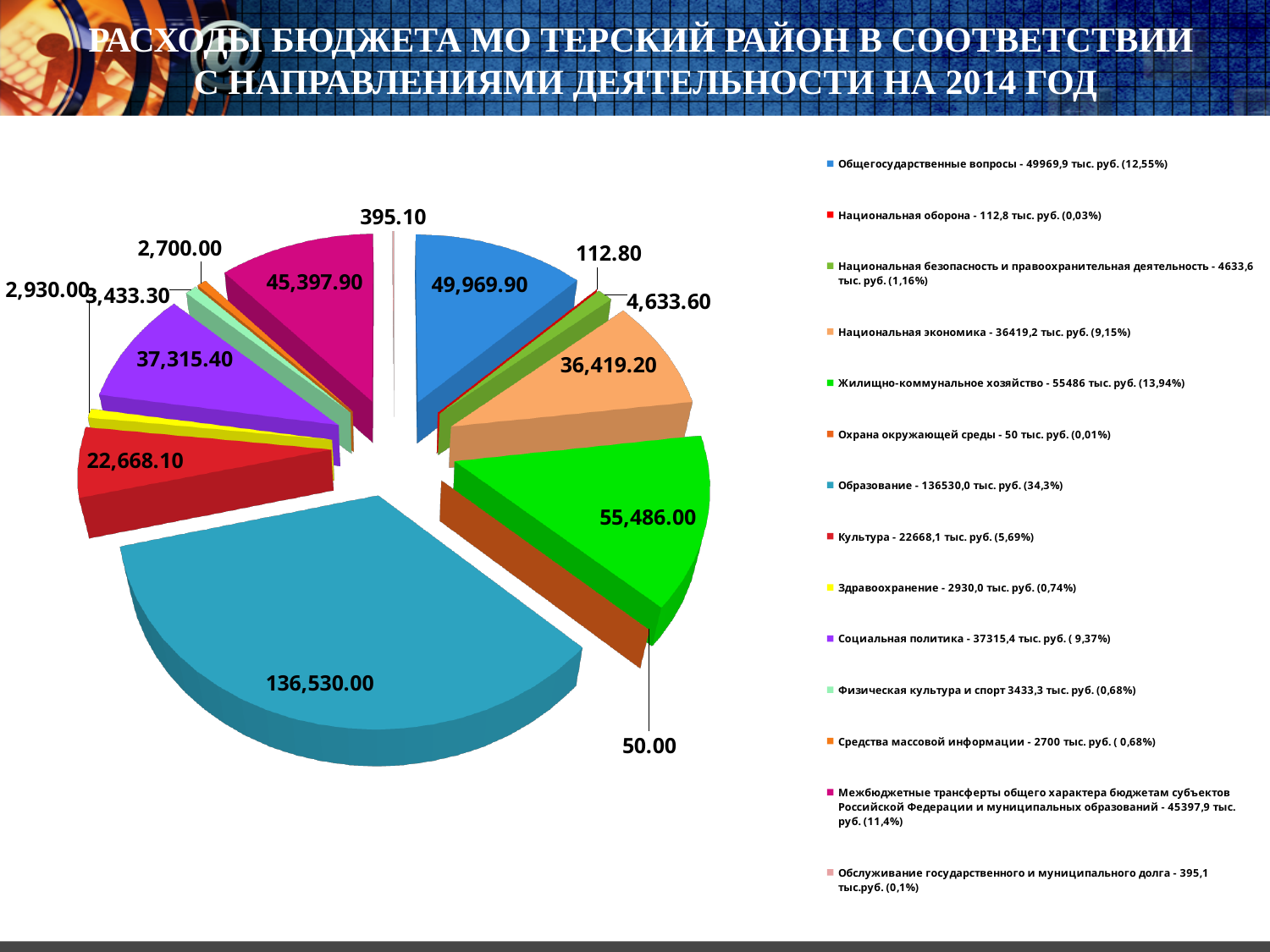
What is the value shown for Жилищно-коммунальное хозяйство? 55,486.00 Which category has the smallest value in the pie chart? Охрана окружающей среды What is the value shown for Национальная оборона? 112.80 Which category has the largest slice of the pie? Образование According to the legend, what share of the budget does Культура account for? 5,69% How many categories does the legend list? 14 What kind of chart is shown on the slide? pie chart What is the value shown for Социальная политика? 37,315.40 What is the difference between the values for Жилищно-коммунальное хозяйство and Общегосударственные вопросы? 5,516.10 According to the legend, what share of the budget does Образование account for? 34,3% Which is larger, the value for Национальная экономика or the value for Социальная политика? Социальная политика What is the value shown for Образование? 136,530.00